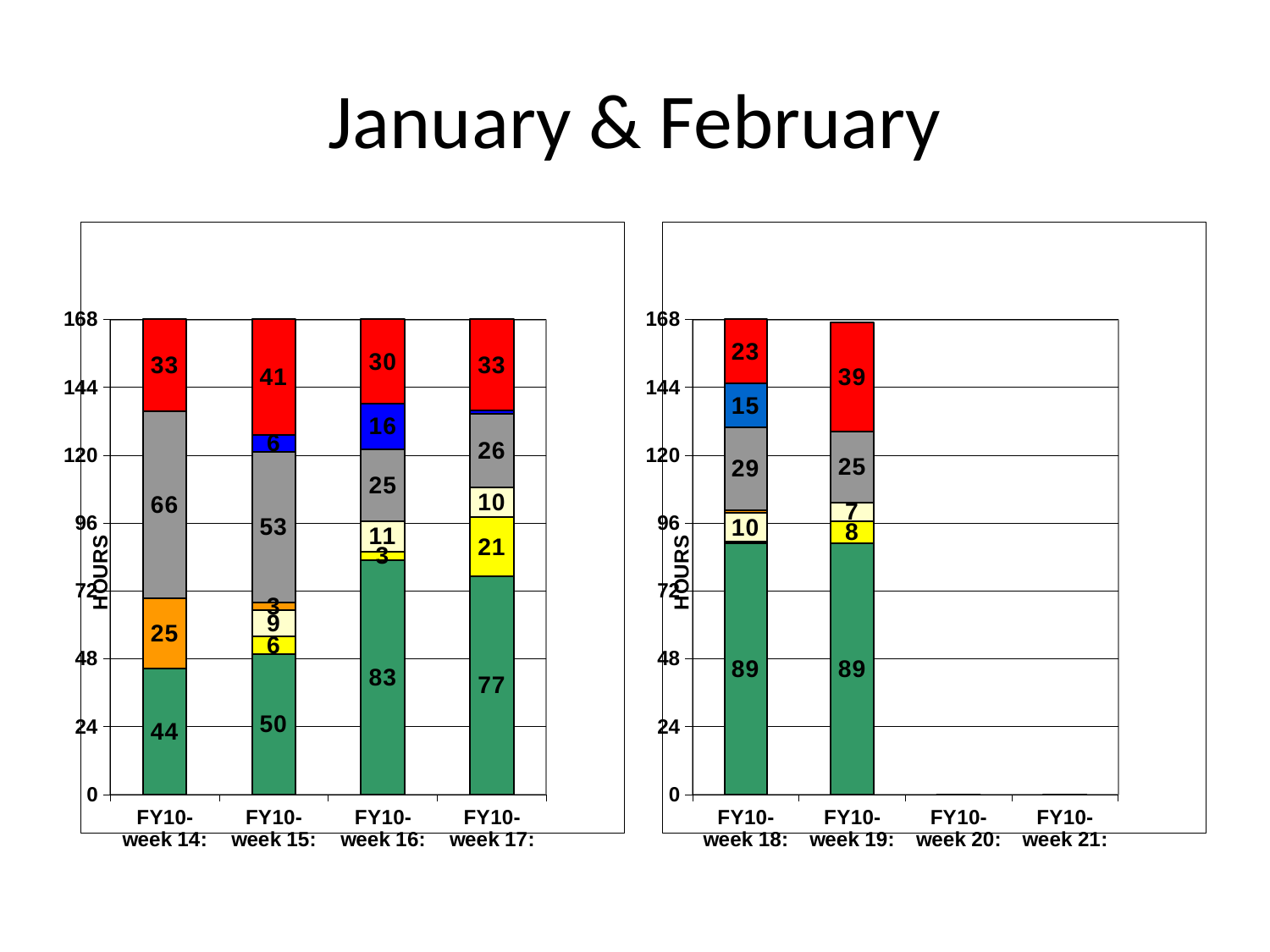
What is the label on the vertical axis of the charts? HOURS In the right chart, what is the value of the gray segment for FY10-week 18? 29 In the left chart, what is the difference between the red segment for FY10-week 15 and the red segment for FY10-week 14? 8 In the left chart, what is the value of the red segment for FY10-week 15? 41 In the left chart, which week has the largest green segment? FY10-week 16 In the left chart, what is the total of the stacked bar for FY10-week 14? 168 In the left chart, what is the value of the green segment for FY10-week 16? 83 In the left chart, which is larger: the gray segment for FY10-week 14 or the gray segment for FY10-week 15? FY10-week 14 In the left chart, which week has the smallest green segment? FY10-week 14 What kind of chart is shown on the left side of the slide? Stacked bar chart In the right chart, what is the value of the red segment for FY10-week 19? 39 In the right chart, how many weeks have a bar with data plotted? 2